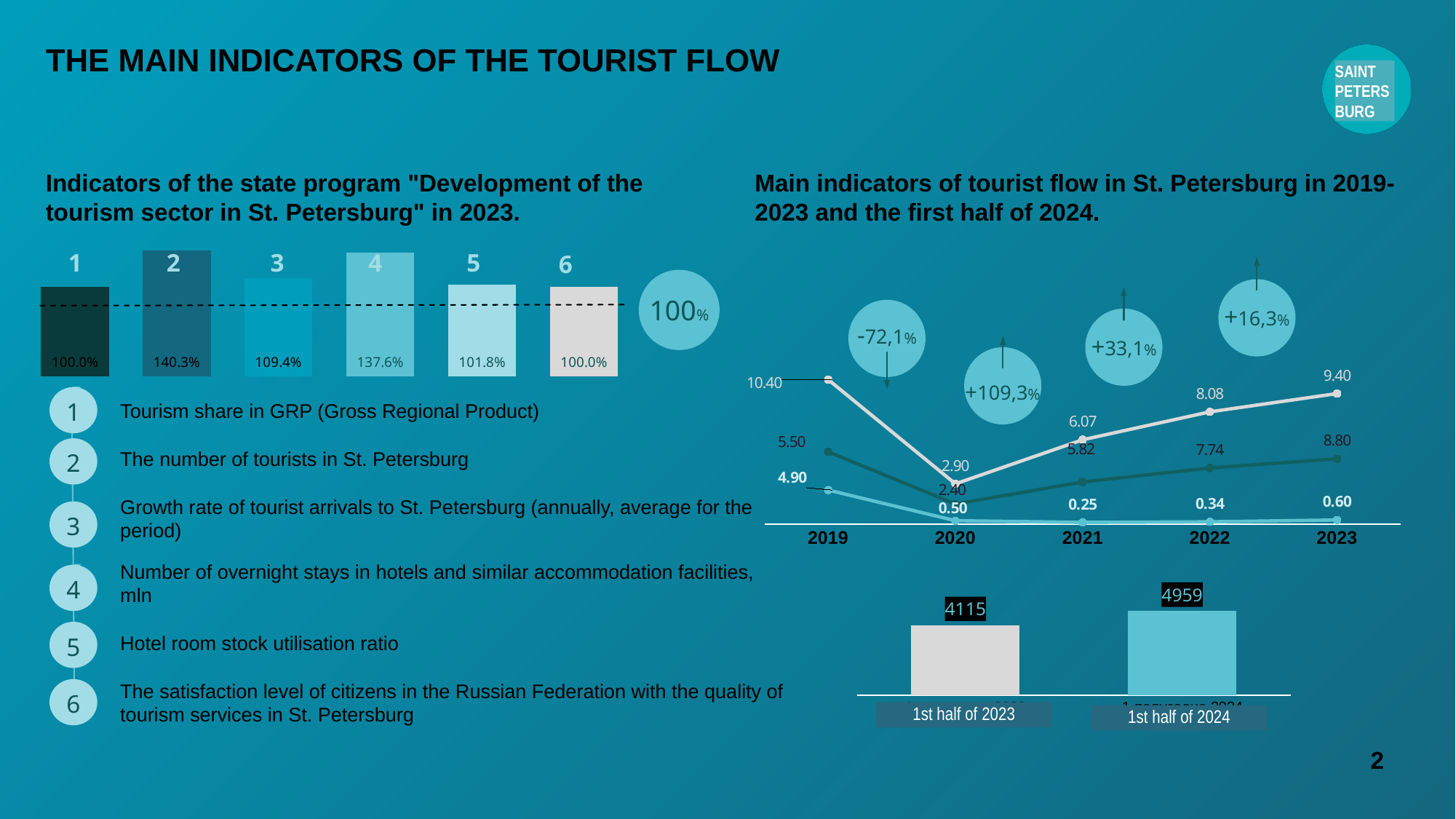
In the bottom bar chart comparing the first halves of 2023 and 2024, what is the value for 1st half of 2024? 4959 In the line chart of main indicators of tourist flow in 2019-2023, what is the value of the top (white) line in 2019? 10.40 In the left bar chart of state program indicators in 2023, what is the value for indicator 4? 137.6% In the line chart of main indicators of tourist flow in 2019-2023, how many years are plotted on the x axis? 5 In the line chart of main indicators of tourist flow in 2019-2023, does the top (white) line rise or fall from 2020 to 2023? Rise In the left bar chart of state program indicators in 2023, which is larger: the value for indicator 3 or indicator 5? Indicator 3 In the left bar chart of state program indicators in 2023, how many bars are shown? 6 In the line chart of main indicators of tourist flow in 2019-2023, in which year does the top (white) line reach its lowest value? 2020 In the bottom bar chart comparing the first halves of 2023 and 2024, what is the difference between the 1st half of 2024 and the 1st half of 2023 values? 844 In the left bar chart of state program indicators in 2023, which indicator has the highest value? 2 In the left bar chart of state program indicators in 2023, what is the value for indicator 2? 140.3% In the line chart of main indicators of tourist flow in 2019-2023, what is the value of the top (white) line in 2023? 9.40